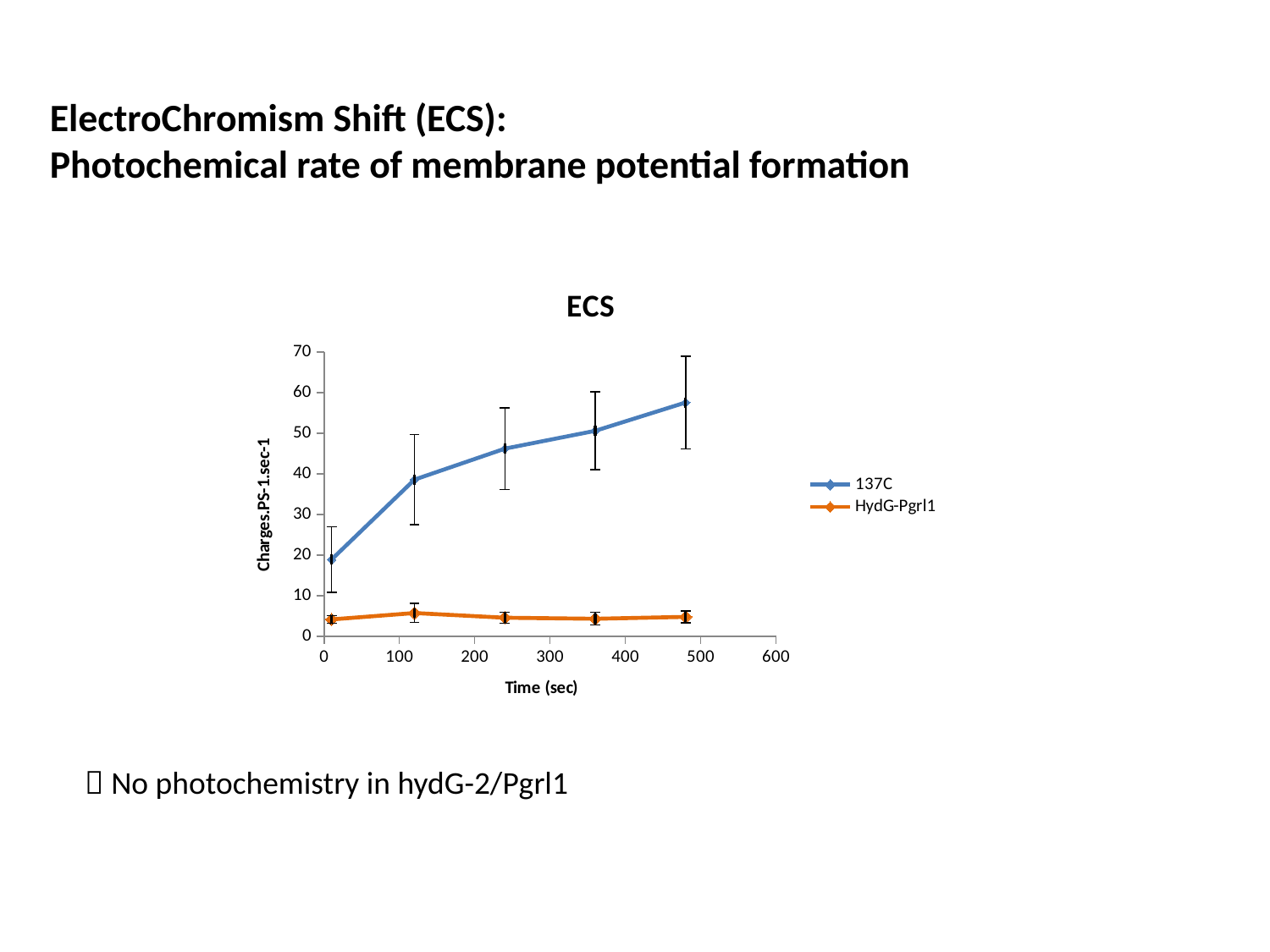
How many data points are plotted for the 137C series? 5 Is the value for 137C at the first time point (near 0 sec) greater or less than 30? less What kind of chart is shown on the slide? line chart How many series does the legend list? 2 Do the values for the 137C series rise or fall as time increases? rise Is the value for 137C at around 240 sec greater or less than 40? greater Which series has the higher values across the time range, 137C or HydG-Pgrl1? 137C What are the names of the two series in the legend? 137C and HydG-Pgrl1 Which series has the lowest values on the chart? HydG-Pgrl1 What is the title of the chart? ECS Is the value for HydG-Pgrl1 at the last time point (around 480 sec) greater or less than 10? less